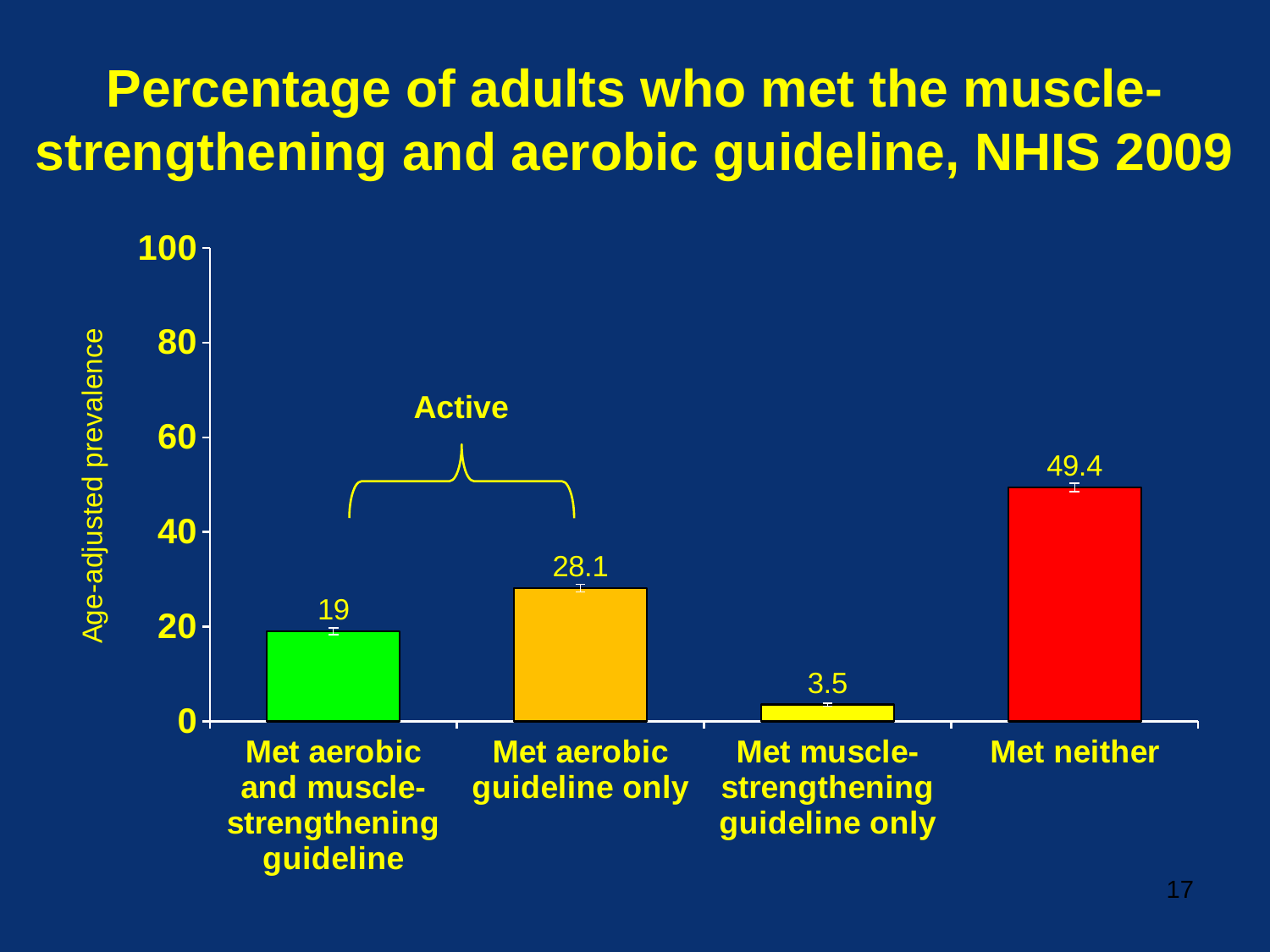
Which category has the lowest age-adjusted prevalence? Met muscle-strengthening guideline only How many categories are shown on the x axis? 4 What is the age-adjusted prevalence for adults who met neither guideline? 49.4 Which two categories are grouped under the bracket labelled 'Active'? Met aerobic and muscle-strengthening guideline; Met aerobic guideline only Which category has the highest age-adjusted prevalence? Met neither What is the value for 'Met muscle-strengthening guideline only'? 3.5 Which is larger: the value for 'Met aerobic guideline only' or 'Met aerobic and muscle-strengthening guideline'? Met aerobic guideline only What is the difference between the values for 'Met neither' and 'Met aerobic guideline only'? 21.3 What is the value for 'Met aerobic guideline only'? 28.1 Is the value for 'Met neither' greater or less than 40? greater What kind of chart is shown on the slide? Bar chart What is the value for 'Met aerobic and muscle-strengthening guideline'? 19